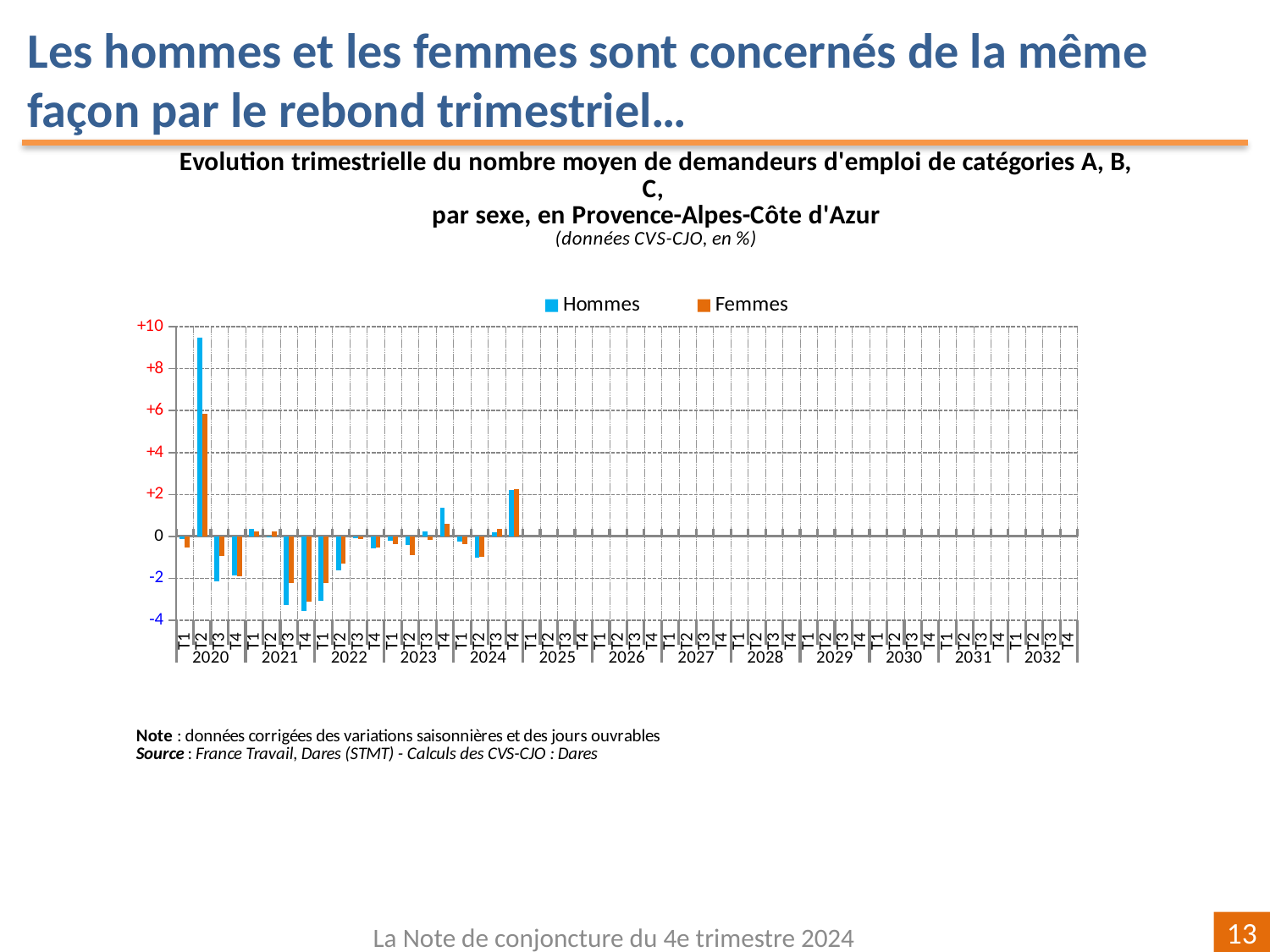
Do the Femmes values rise or fall from T2 2024 to T4 2024? rise Is the value for Hommes in T2 2020 greater or less than +8? greater How many series does the legend list? 2 Which series is shown in orange? Femmes In which quarter does the Hommes series reach its lowest value? T4 2021 In which quarter does the Hommes series reach its highest value? T2 2020 Is the value for Femmes in T4 2024 greater or less than 0? greater What kind of chart is shown on the slide? bar chart In T2 2020, which series has the larger value, Hommes or Femmes? Hommes In T4 2021, which series has the lower value, Hommes or Femmes? Hommes Is the value for Hommes in T4 2021 greater or less than -2? less